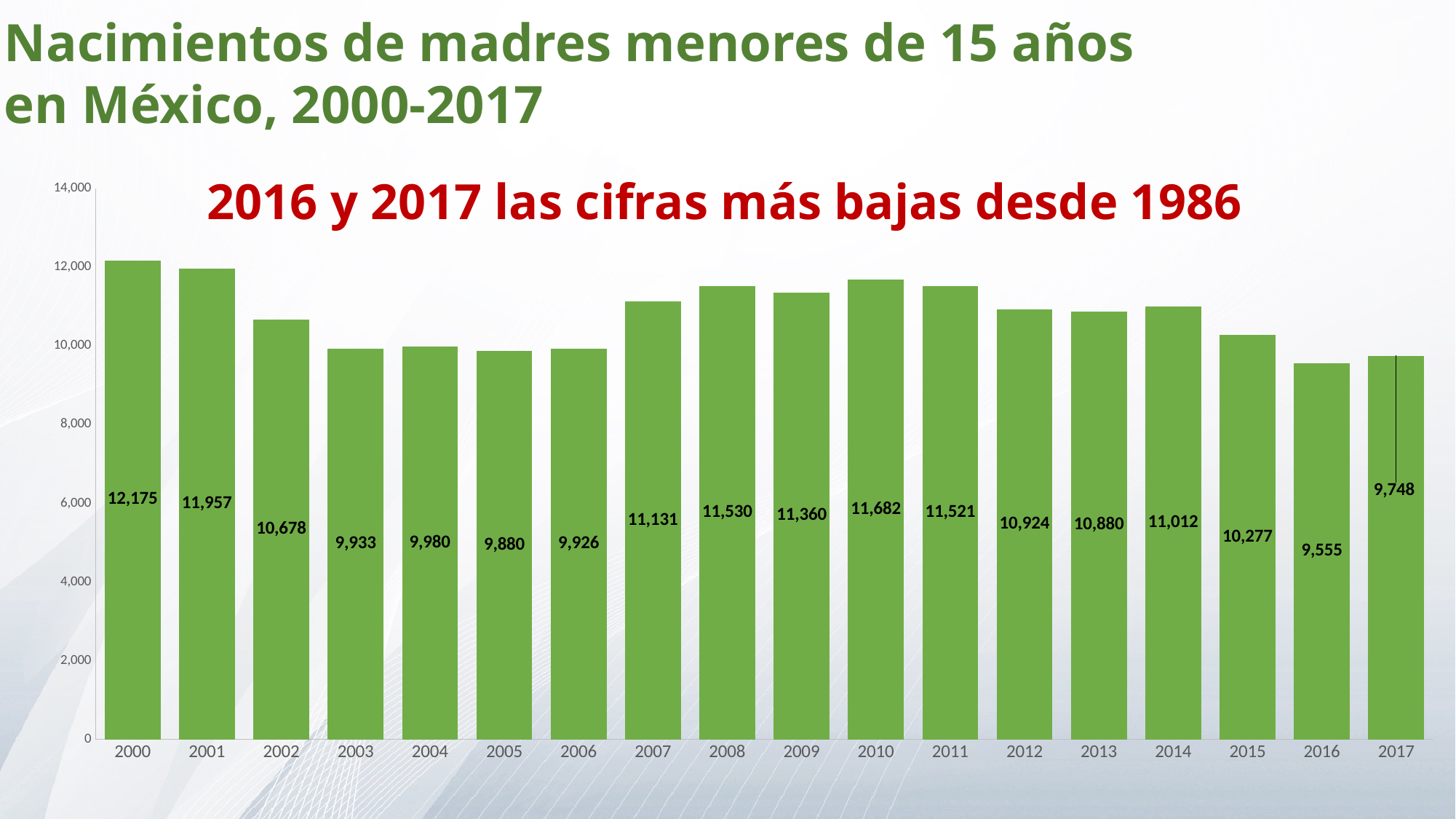
What colour are the bars in the chart? green Which year has the highest value? 2000 What is the value for 2010? 11,682 Is the value for 2015 greater or less than 10,000? greater Do the values rise or fall from 2014 to 2016? fall Which year has the lowest value? 2016 How many years are shown on the x axis? 18 What is the difference between the values for 2000 and 2017? 2,427 What is the value for 2000? 12,175 What is the value for 2016? 9,555 What kind of chart is shown on the slide? bar chart Which is larger, the value for 2008 or the value for 2009? 2008